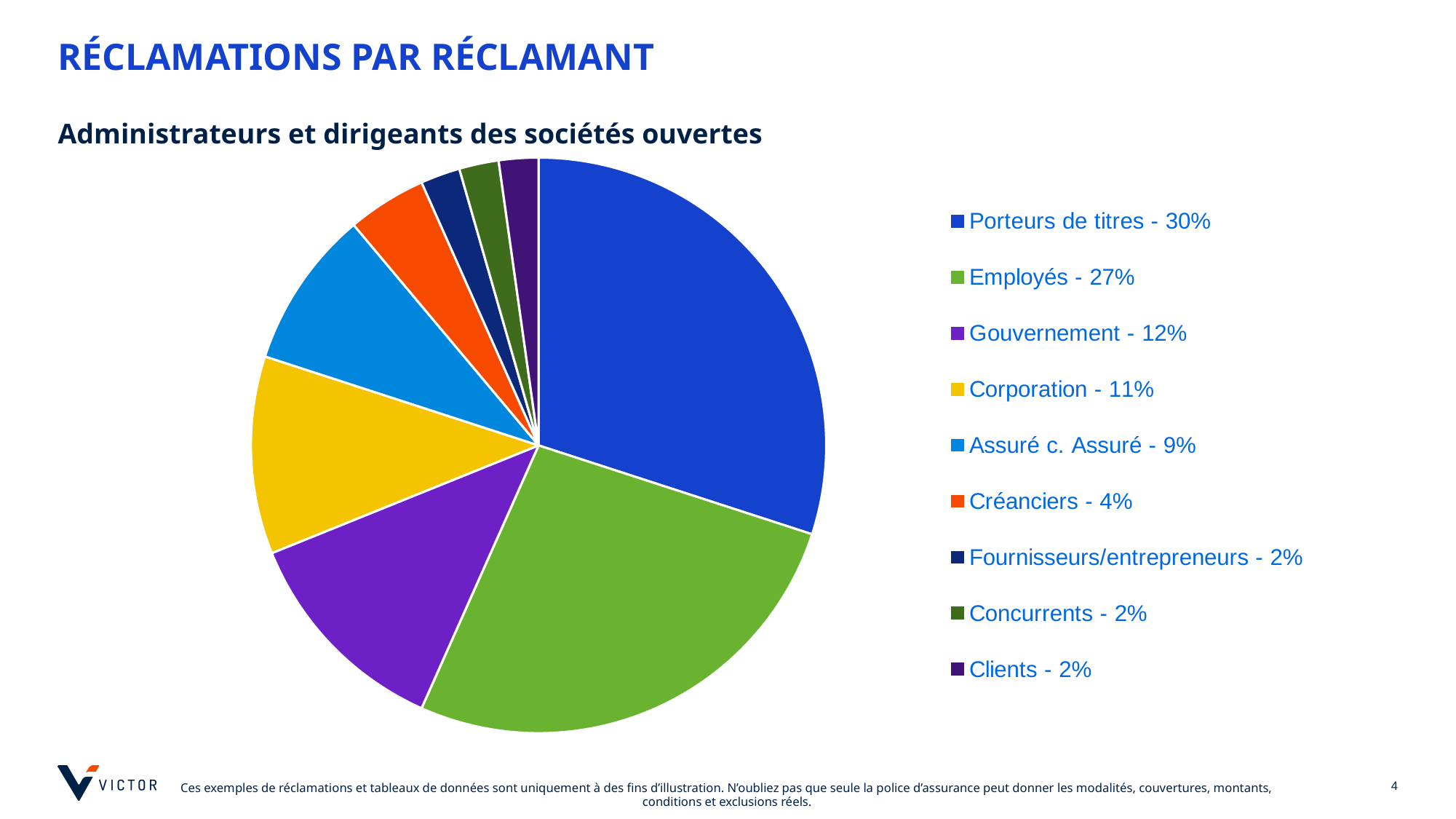
Which category has the largest slice of the pie? Porteurs de titres How many categories are shown in the pie chart? 9 What is the difference between Gouvernement and Créanciers? 8% What percentage does the Employés slice represent? 27% What colour is the Corporation slice? Yellow What is the combined share of Fournisseurs/entrepreneurs, Concurrents and Clients? 6% What is the value shown for Gouvernement? 12% What share of claims is attributed to Porteurs de titres? 30% What kind of chart is shown on the slide? Pie chart What is the title of the chart? Administrateurs et dirigeants des sociétés ouvertes Which is larger, Corporation or Assuré c. Assuré? Corporation What is the difference in percentage points between Porteurs de titres and Employés? 3%